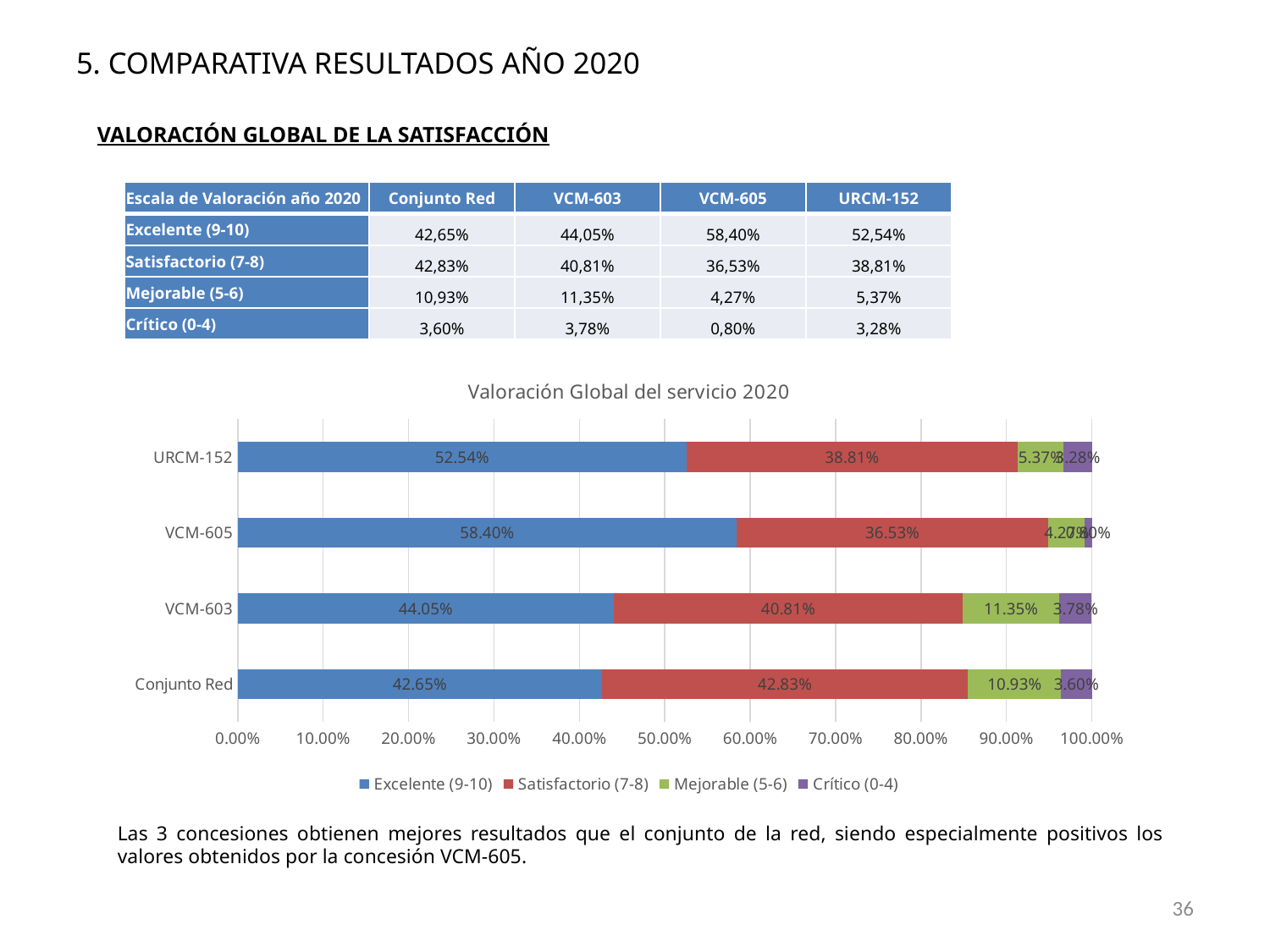
What is the Crítico (0-4) value for Conjunto Red in the chart? 3.60% How many categories are plotted on the chart? 4 Is the Satisfactorio (7-8) value for VCM-603 larger than that for Conjunto Red? No What is the title of the chart? Valoración Global del servicio 2020 What is the Excelente (9-10) value for VCM-605 in the chart? 58.40% What is the Mejorable (5-6) value for VCM-603 in the chart? 11.35% What type of chart is shown on the slide? stacked bar chart What is the Satisfactorio (7-8) value for URCM-152 in the chart? 38.81% How many series does the chart legend list? 4 Which category has the highest Excelente (9-10) value? VCM-605 What is the difference between the Excelente (9-10) values of VCM-605 and Conjunto Red? 15.75% Which category has the lowest Mejorable (5-6) value? VCM-605